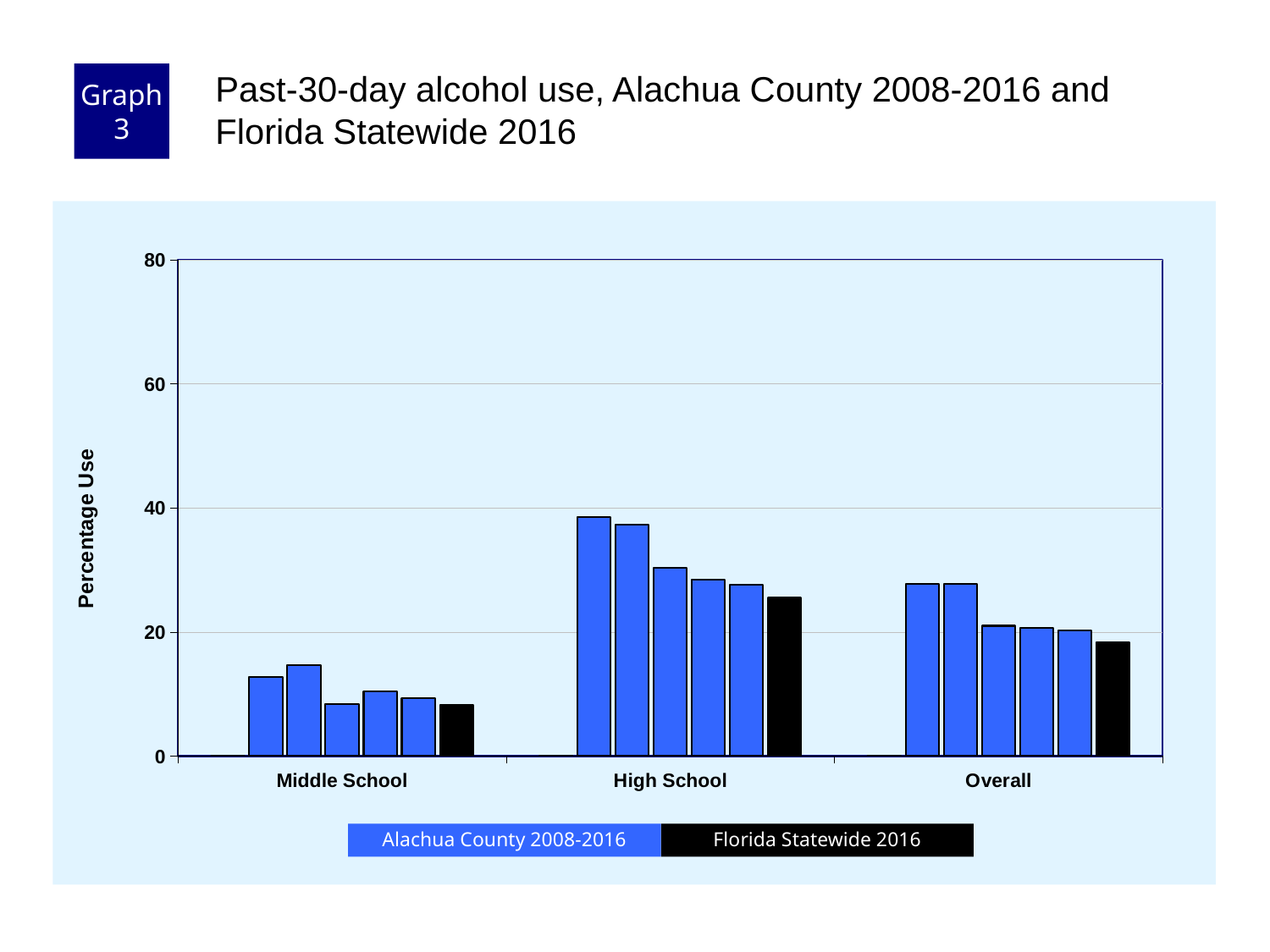
Is the Florida Statewide 2016 value for High School greater or less than 20? greater How many series does the legend list? 2 Is the Florida Statewide 2016 value for Middle School greater or less than 20? less How many categories are shown on the x axis? 3 What is the label on the y axis? Percentage Use What kind of chart is shown on the slide? bar chart Which colour represents Florida Statewide 2016 in the legend? black Do the Alachua County 2008-2016 bars for High School rise or fall from left to right? fall Which category has the lowest bars? Middle School Is the Florida Statewide 2016 value for High School larger than the Florida Statewide 2016 value for Middle School? yes Which category has the highest bars? High School Are all the Alachua County 2008-2016 bars for Middle School greater or less than 20? less